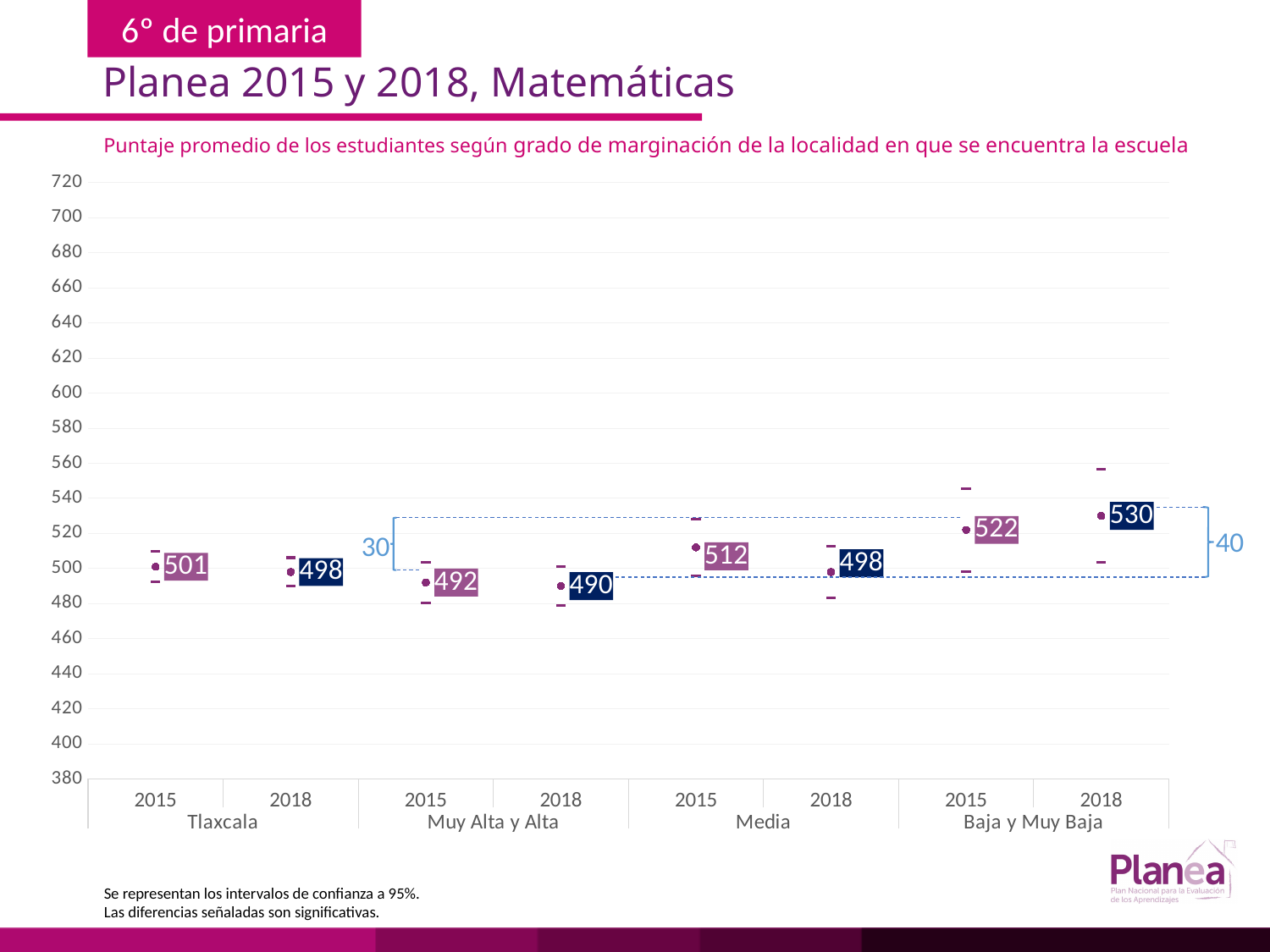
Which is larger, the Tlaxcala 2018 score or the Media 2018 score? They are equal (498) How many marginalization groups are shown on the x axis? 4 What is the average score for Media in 2015? 512 What is the average score for Muy Alta y Alta in 2018? 490 Which group and year has the lowest average score? Muy Alta y Alta, 2018 What is the subtitle of the chart? Puntaje promedio de los estudiantes según grado de marginación de la localidad en que se encuentra la escuela What is the difference between the Media scores in 2015 and 2018? 14 What is the average score for Baja y Muy Baja in 2018? 530 What is the average score for Tlaxcala in 2015? 501 What is the difference between the Baja y Muy Baja scores in 2018 and 2015? 8 Which group and year has the highest average score? Baja y Muy Baja, 2018 Is the value for Baja y Muy Baja in 2015 greater or less than 500? greater